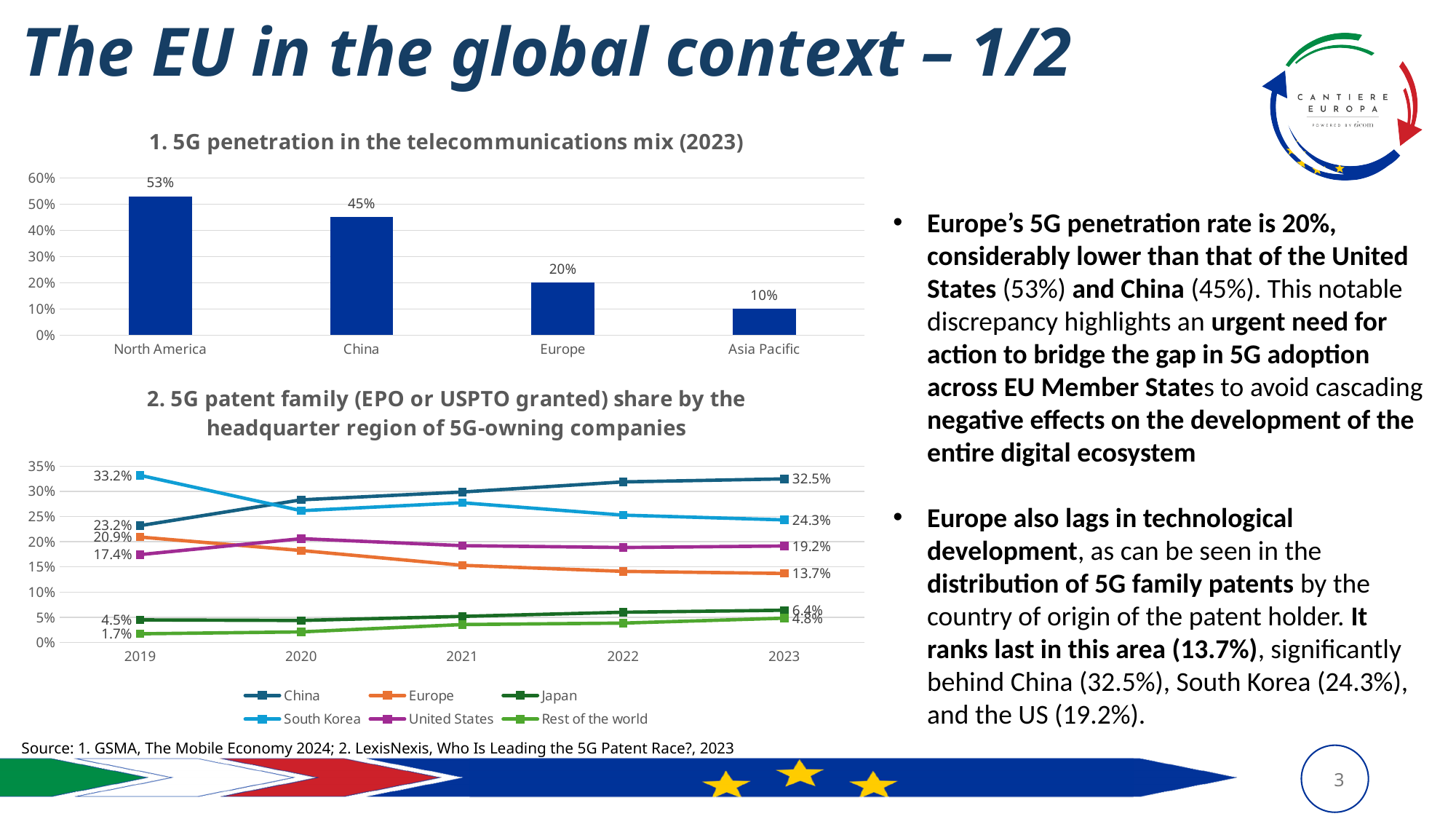
In the chart '1. 5G penetration in the telecommunications mix (2023)', which region has the highest 5G penetration? North America How many regions are shown in the chart '1. 5G penetration in the telecommunications mix (2023)'? 4 In the chart '2. 5G patent family share by the headquarter region of 5G-owning companies', by how much did Europe's share decrease between 2019 (20.9%) and 2023 (13.7%)? 7.2 percentage points In the chart '1. 5G penetration in the telecommunications mix (2023)', which region has the lowest 5G penetration? Asia Pacific What kind of chart is '1. 5G penetration in the telecommunications mix (2023)'? Bar chart How many series does the legend list in the chart '2. 5G patent family (EPO or USPTO granted) share by the headquarter region of 5G-owning companies'? 6 In the chart '2. 5G patent family share by the headquarter region of 5G-owning companies', what is China's share in 2023? 32.5% In the chart '1. 5G penetration in the telecommunications mix (2023)', what is the value for Europe? 20% In the chart '2. 5G patent family share by the headquarter region of 5G-owning companies', is Japan's value in 2021 greater or less than 10%? less In the chart '2. 5G patent family share by the headquarter region of 5G-owning companies', what is South Korea's share in 2019? 33.2% In the chart '1. 5G penetration in the telecommunications mix (2023)', how much higher is North America's value than China's? 8 percentage points In the chart '2. 5G patent family share by the headquarter region of 5G-owning companies', does Europe's share rise or fall from 2019 to 2023? Fall